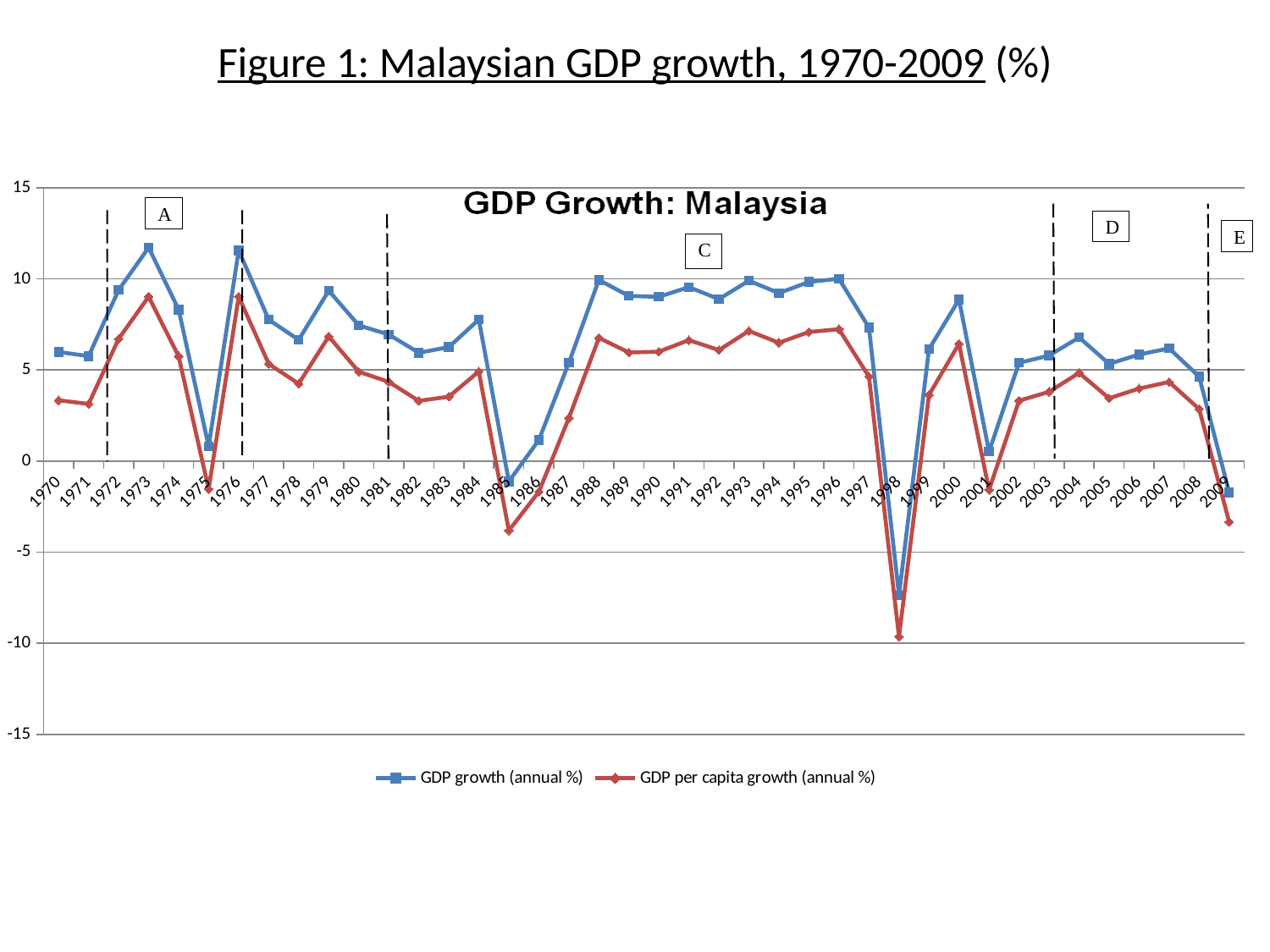
How many years are plotted along the x axis? 40 Is the value for GDP growth (annual %) in 1988 greater or less than 5? greater Does GDP growth (annual %) rise or fall from 1985 to 1988? rise Is the value for GDP growth (annual %) in 1998 greater or less than -5? less How many series does the legend list? 2 In which year is GDP per capita growth (annual %) at its lowest? 1998 What kind of chart is shown on the slide? line chart Is the value for GDP per capita growth (annual %) in 1985 greater or less than 0? less Which is larger, GDP growth (annual %) in 1988 or in 1985? 1988 What is the title printed inside the chart area? GDP Growth: Malaysia In which year is GDP growth (annual %) at its lowest? 1998